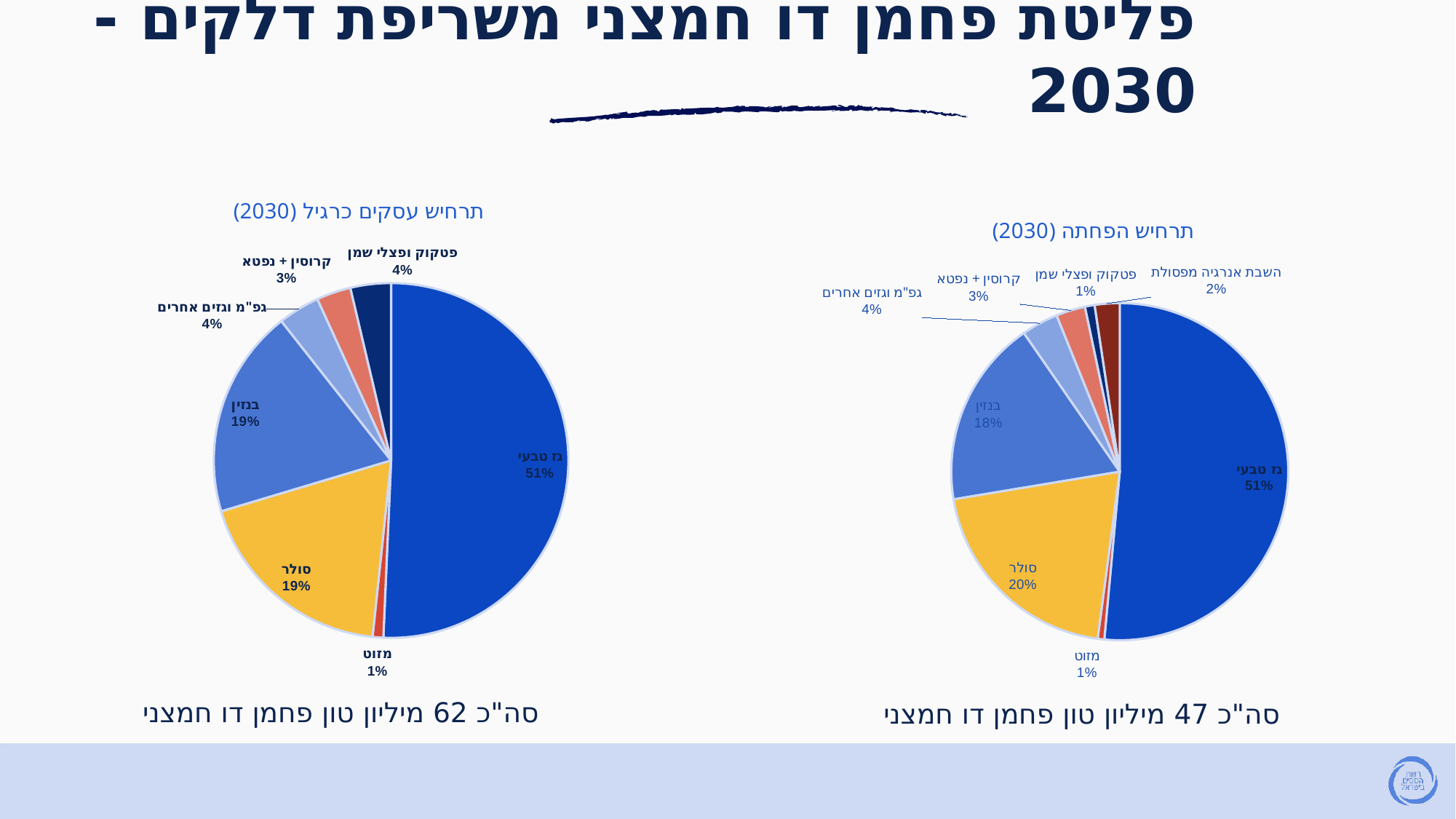
What type of chart is used on this slide? Pie chart How many slices does the left pie chart (תרחיש עסקים כרגיל 2030) have? 7 How many slices does the right pie chart (תרחיש הפחתה 2030) have? 8 In the left pie chart (תרחיש עסקים כרגיל 2030), what is the difference in percentage points between גז טבעי and סולר? 32 In the left pie chart (תרחיש עסקים כרגיל 2030), what share does גז טבעי have? 51% In the left pie chart (תרחיש עסקים כרגיל 2030), which category has the largest share? גז טבעי In the right pie chart (תרחיש הפחתה 2030), what share does השבת אנרגיה מפסולת have? 2% In the right pie chart (תרחיש הפחתה 2030), which is larger: סולר or בנזין? סולר In the left pie chart (תרחיש עסקים כרגיל 2030), which category has the smallest share? מזוט In the left pie chart (תרחיש עסקים כרגיל 2030), what share does סולר have? 19%